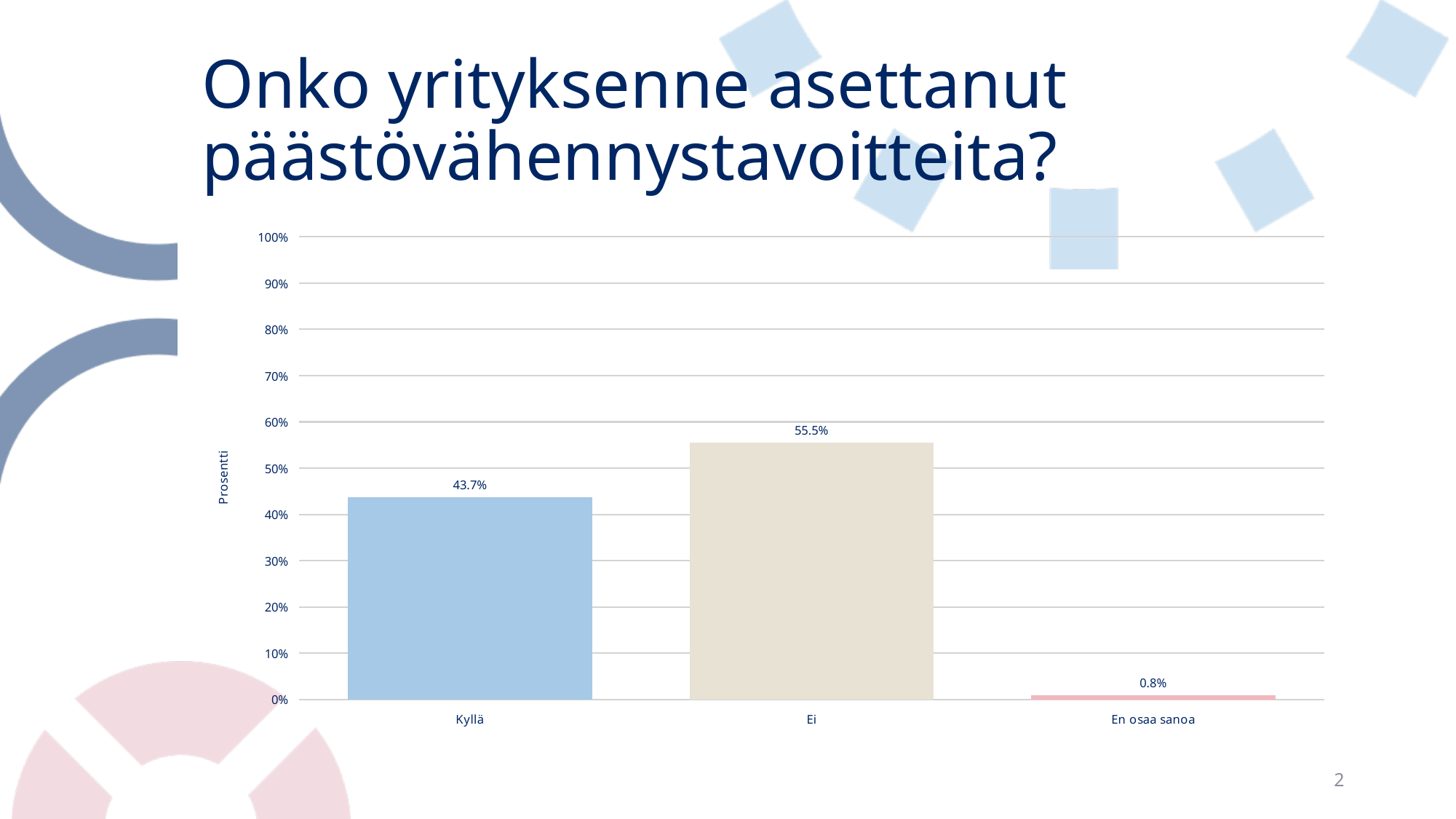
How many categories are shown on the x axis? 3 Which is larger, the value for Kyllä or the value for Ei? Ei Is the value for Kyllä greater or less than 50%? less Which category has the highest value? Ei What kind of chart is shown on the slide? bar chart Which category has the lowest value? En osaa sanoa What is the title of the slide above the chart? Onko yrityksenne asettanut päästövähennystavoitteita? What is the label of the vertical axis? Prosentti What is the value for En osaa sanoa? 0.8% What is the difference between the values for Ei and Kyllä? 11.8% What is the value for Kyllä? 43.7% What is the value for Ei? 55.5%